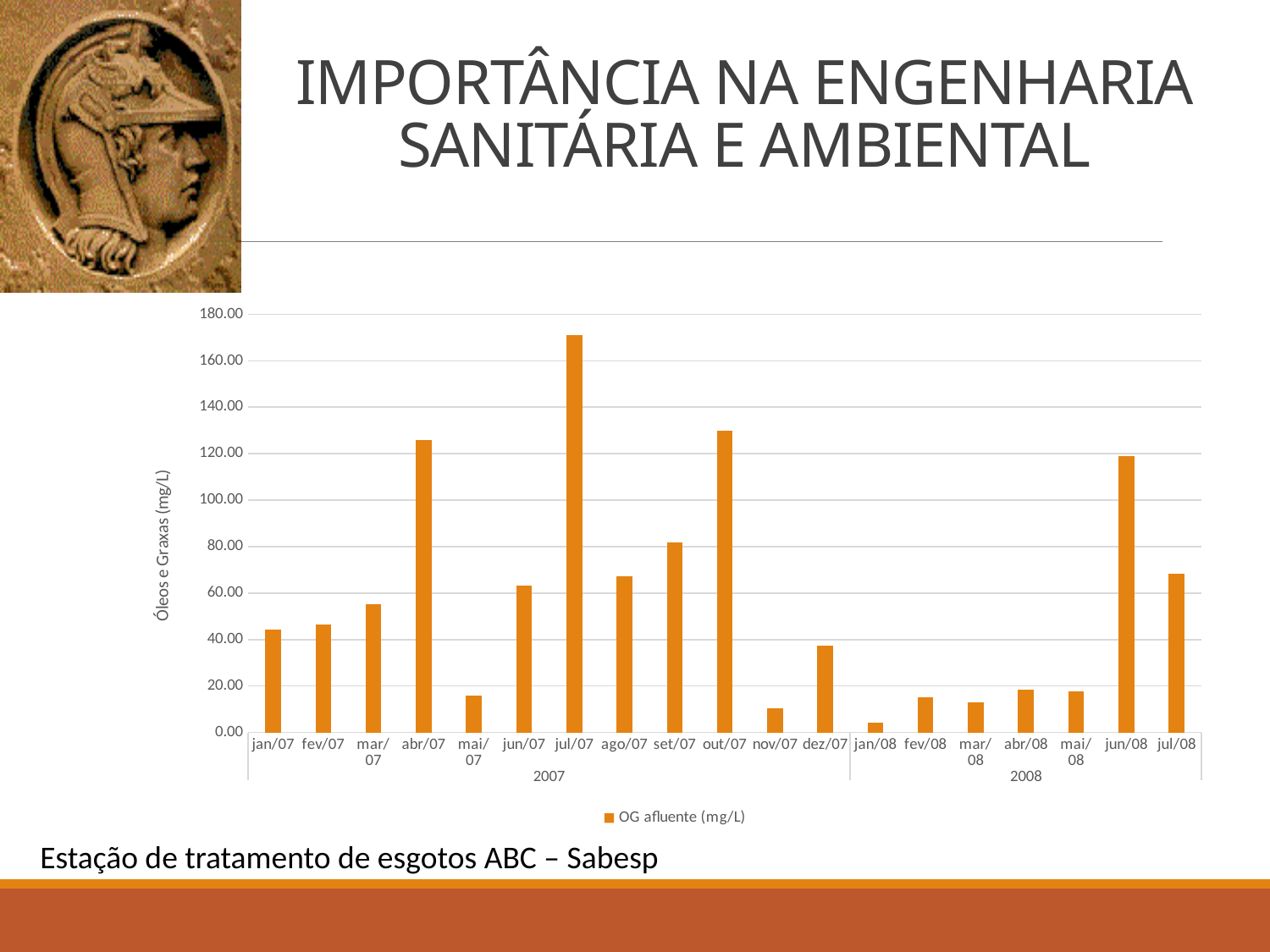
Which is larger, the value for jun/08 or the value for jul/08? jun/08 Is the value for jun/08 greater or less than 100? greater How many months (bars) are plotted in the chart? 19 Which month has the highest OG afluente value? jul/07 How many series does the legend list? 1 Which month has the lowest OG afluente value? jan/08 What kind of chart is shown on the slide? bar chart Is the value for out/07 greater or less than 120? greater Is the value for jul/07 greater or less than 160? greater Do the values rise or fall from out/07 to jan/08? fall What is the label on the vertical axis of the chart? Óleos e Graxas (mg/L)